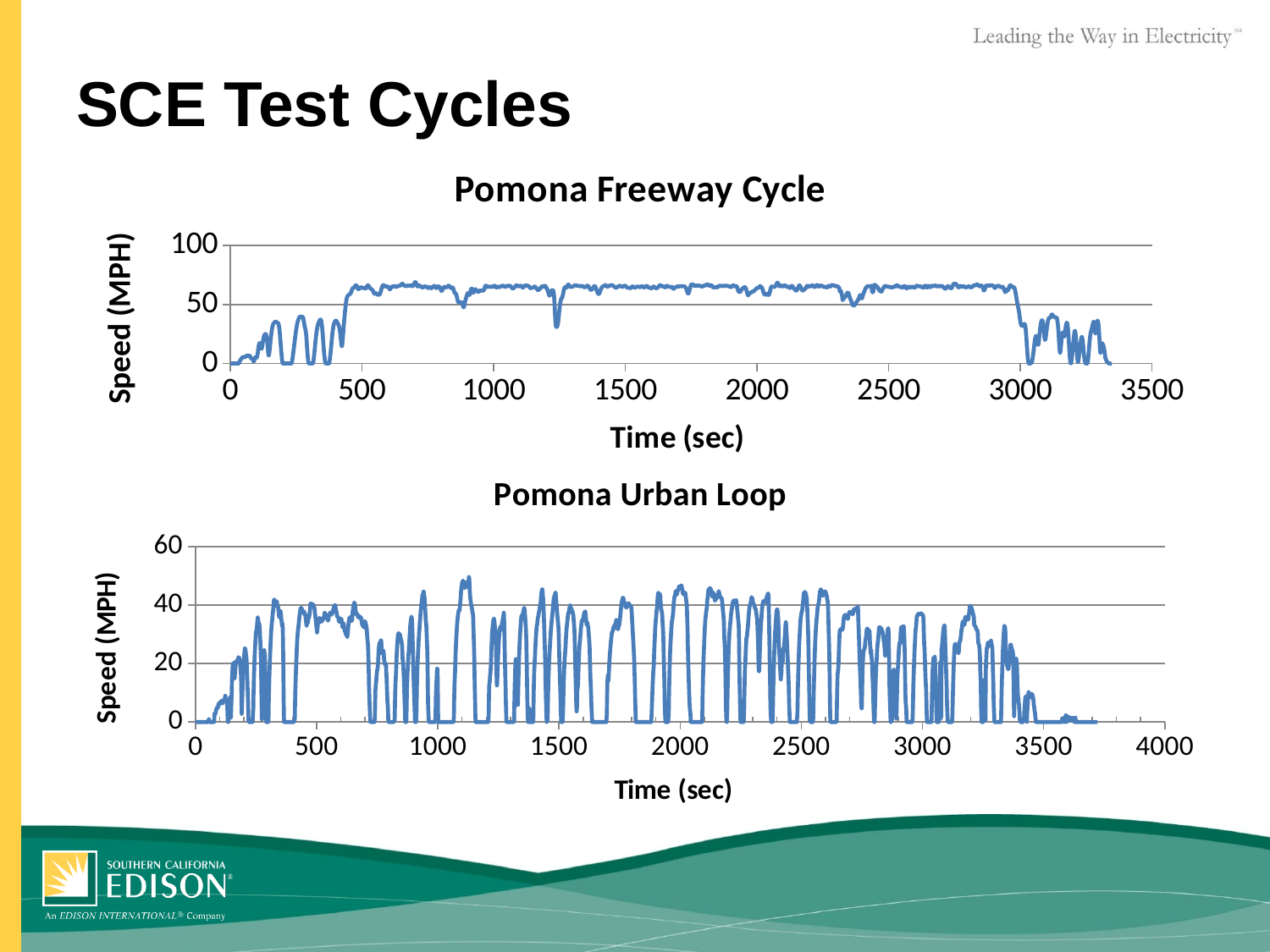
What kind of chart is the Pomona Freeway Cycle chart? line chart Which is larger: the speed at 2000 seconds in the Pomona Freeway Cycle chart or the speed at 2000 seconds in the Pomona Urban Loop chart? Pomona Freeway Cycle In the Pomona Freeway Cycle chart, is the speed at 2500 seconds greater or less than 50 MPH? greater In the Pomona Freeway Cycle chart, is the speed at 1500 seconds greater or less than 50 MPH? greater In the Pomona Urban Loop chart, is the speed at 3600 seconds greater or less than 20 MPH? less What is the highest value shown on the y axis of the Pomona Urban Loop chart? 60 In the Pomona Urban Loop chart, does the speed rise or fall between 3400 and 3700 seconds? fall What kind of chart is the Pomona Urban Loop chart? line chart What is the x-axis title of the Pomona Freeway Cycle chart? Time (sec) In the Pomona Freeway Cycle chart, does the speed generally rise or fall between 0 and 500 seconds? rise